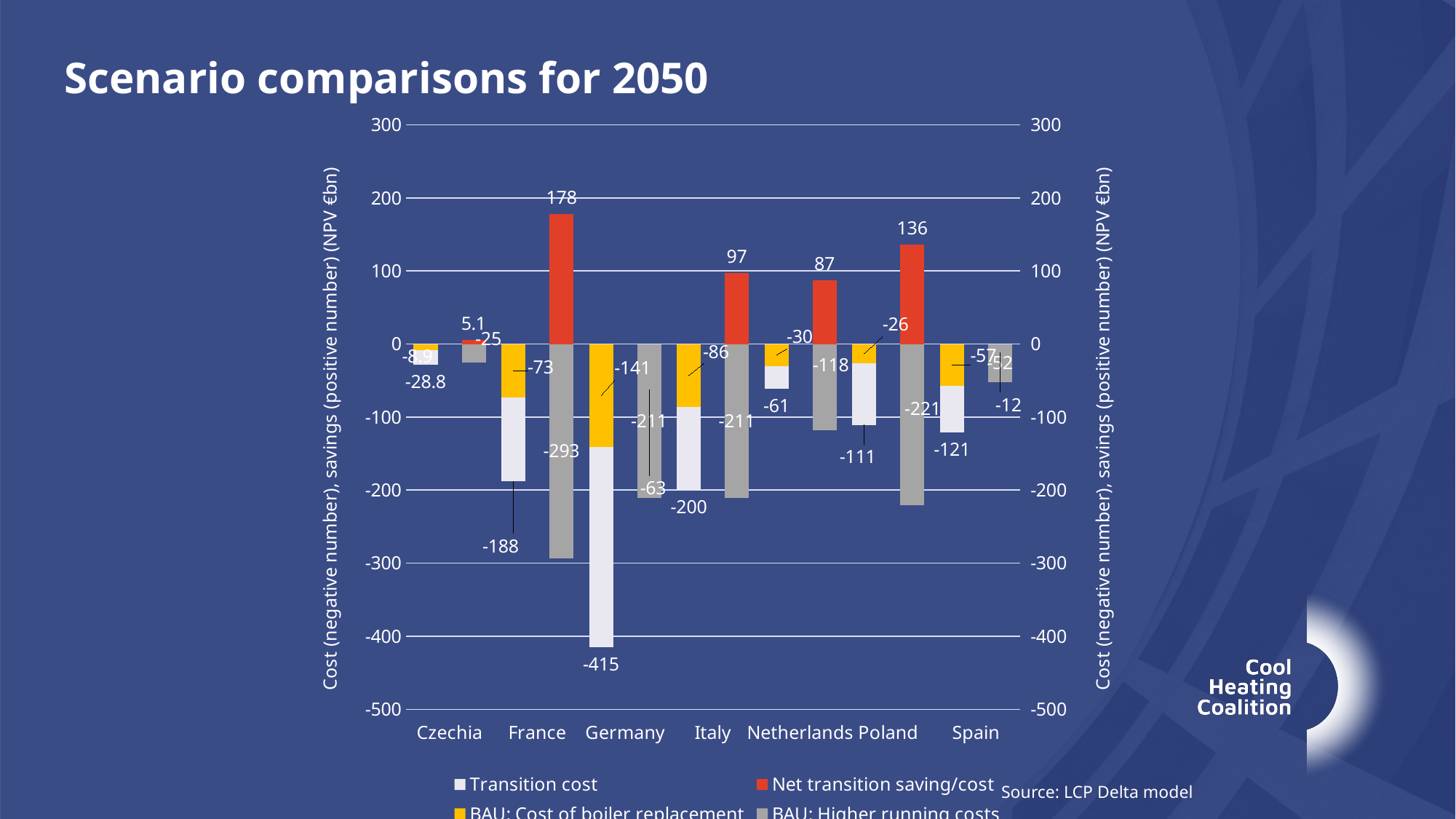
What is the Net transition saving/cost value for France? 178 What is the BAU: Cost of boiler replacement value for Spain? -57 How many countries are shown on the x axis of the chart? 7 What is the Transition cost value for Czechia? -28.8 What is the Transition cost value for Germany? -415 What is the difference between the Net transition saving/cost for France and for Poland? 42 Which is larger, the Net transition saving/cost for Italy or for the Netherlands? Italy Which country has the highest Net transition saving/cost value? France What is the title of the chart on the slide? Scenario comparisons for 2050 What kind of chart is shown on the slide? bar chart How many series does the chart's legend list? 4 What is the BAU: Higher running costs value for Poland? -221